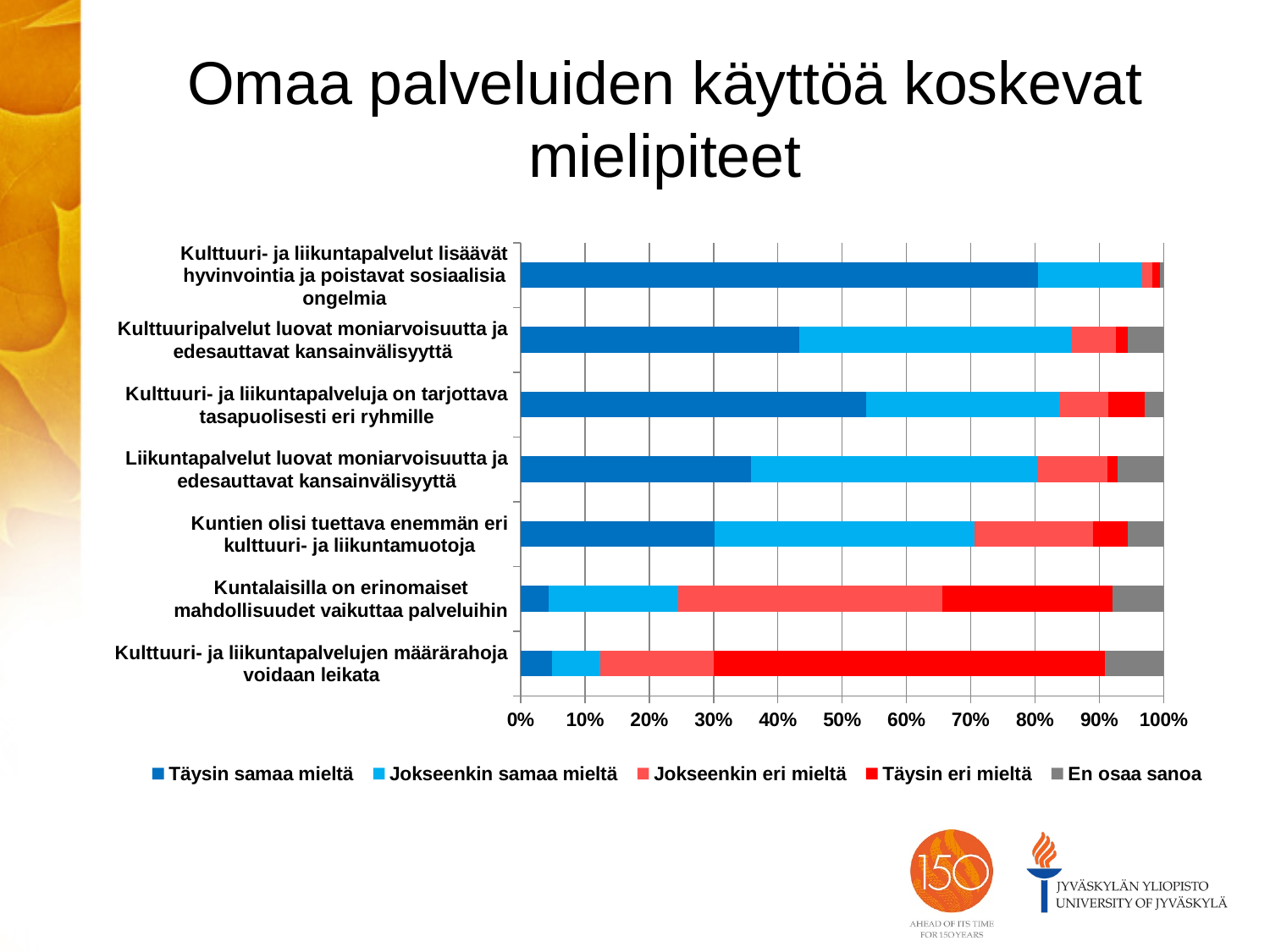
Which statement has the largest 'Täysin samaa mieltä' share? Kulttuuri- ja liikuntapalvelut lisäävät hyvinvointia ja poistavat sosiaalisia ongelmia How many series does the legend list? 5 Which has the larger 'Täysin samaa mieltä' share: 'Kulttuuripalvelut luovat moniarvoisuutta ja edesauttavat kansainvälisyyttä' or 'Liikuntapalvelut luovat moniarvoisuutta ja edesauttavat kansainvälisyyttä'? Kulttuuripalvelut luovat moniarvoisuutta ja edesauttavat kansainvälisyyttä Is the 'Täysin samaa mieltä' share for 'Kuntalaisilla on erinomaiset mahdollisuudet vaikuttaa palveluihin' greater or less than 10%? less What is the total of the stacked bar for 'Kuntien olisi tuettava enemmän eri kulttuuri- ja liikuntamuotoja'? 100% Which legend entry is shown in grey? En osaa sanoa What kind of chart is shown on the slide? Stacked bar chart What is the title of the slide containing the chart? Omaa palveluiden käyttöä koskevat mielipiteet How many statements (categories) are plotted on the chart? 7 Which statement has the largest 'Täysin eri mieltä' share? Kulttuuri- ja liikuntapalvelujen määrärahoja voidaan leikata Is the 'Täysin eri mieltä' share for 'Kulttuuri- ja liikuntapalvelujen määrärahoja voidaan leikata' greater or less than 50%? greater Is the 'Täysin samaa mieltä' share for 'Kulttuuri- ja liikuntapalvelut lisäävät hyvinvointia ja poistavat sosiaalisia ongelmia' greater or less than 70%? greater